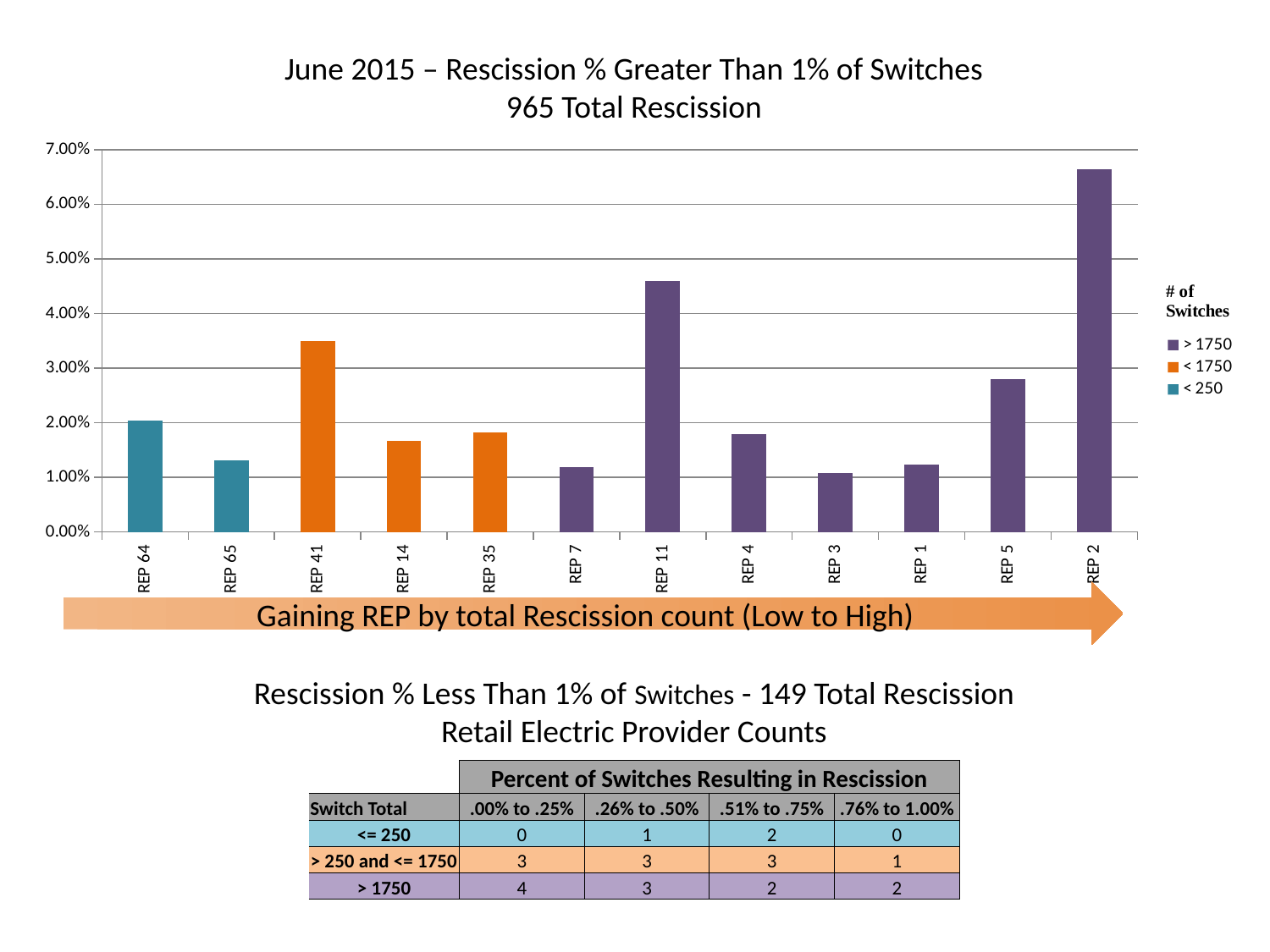
What is the title of the chart? June 2015 – Rescission % Greater Than 1% of Switches 965 Total Rescission Is the value for REP 11 greater or less than 4.00%? greater Is the value for REP 41 greater or less than 3.00%? greater Which has the larger rescission percentage, REP 11 or REP 41? REP 11 What kind of chart is shown on the slide? bar chart Which REP has the highest rescission percentage in the chart? REP 2 How many series does the chart's legend list? 3 How many REP categories are plotted on the x axis of the chart? 12 Which legend series does the bar for REP 41 belong to? < 1750 Which has the larger rescission percentage, REP 64 or REP 65? REP 64 Is the value for REP 14 greater or less than 2.00%? less